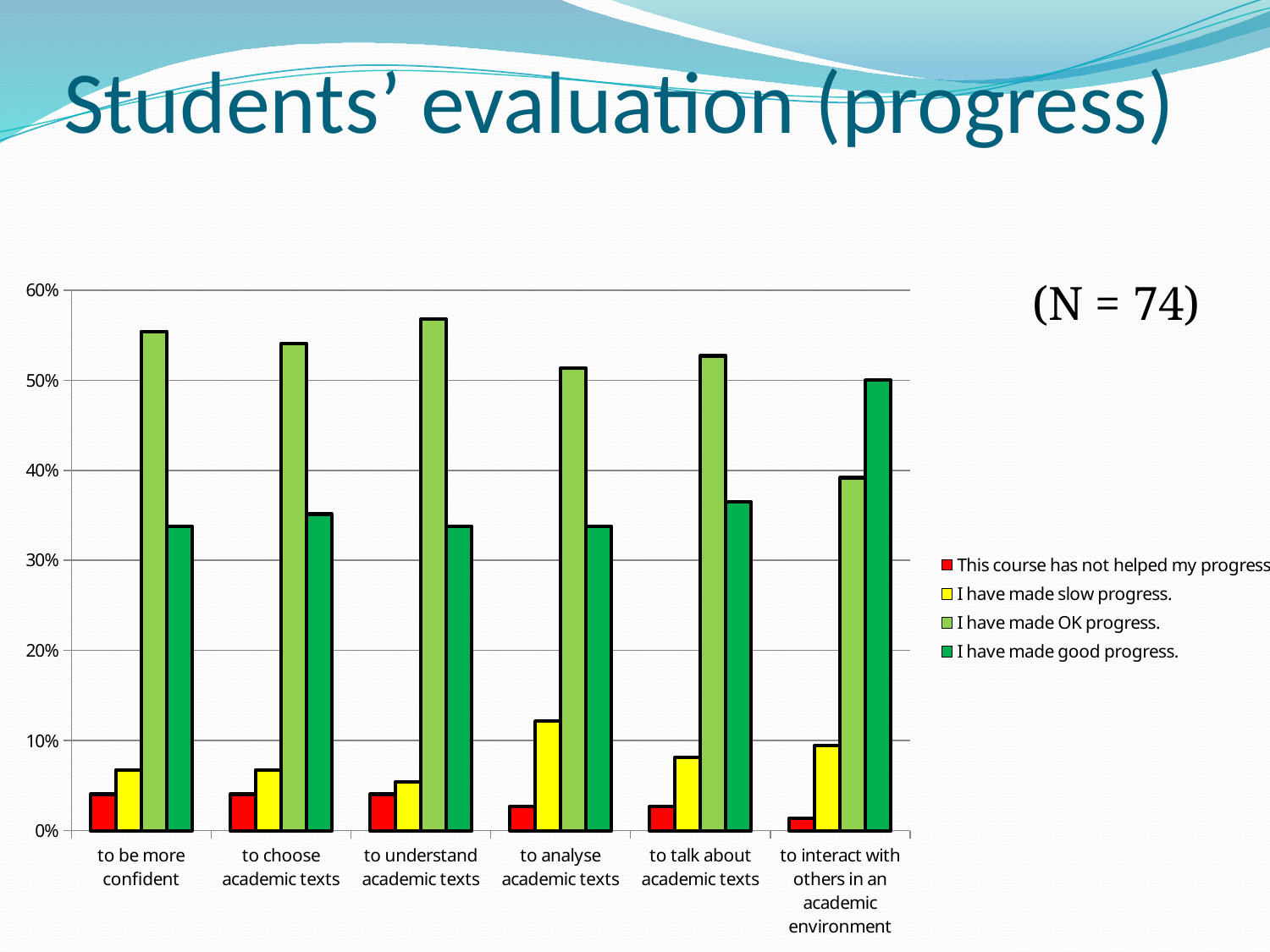
What sample size (N) is stated next to the chart? N = 74 How many categories are shown along the x axis? 6 For "to analyse academic texts", which is larger: "I have made slow progress." or "This course has not helped my progress."? I have made slow progress. Which category has the lowest value for "I have made OK progress."? to interact with others in an academic environment Which category has the lowest value for "This course has not helped my progress."? to interact with others in an academic environment What kind of chart is shown on the slide? bar chart Is the value of "I have made slow progress." for "to analyse academic texts" greater or less than 10%? greater How many series does the legend list? 4 Which category has the highest value for "I have made good progress."? to interact with others in an academic environment Which category has the highest value for "I have made slow progress."? to analyse academic texts Is the value of "I have made good progress." for "to interact with others in an academic environment" greater or less than 40%? greater Is the value of "I have made OK progress." for "to understand academic texts" greater or less than 50%? greater